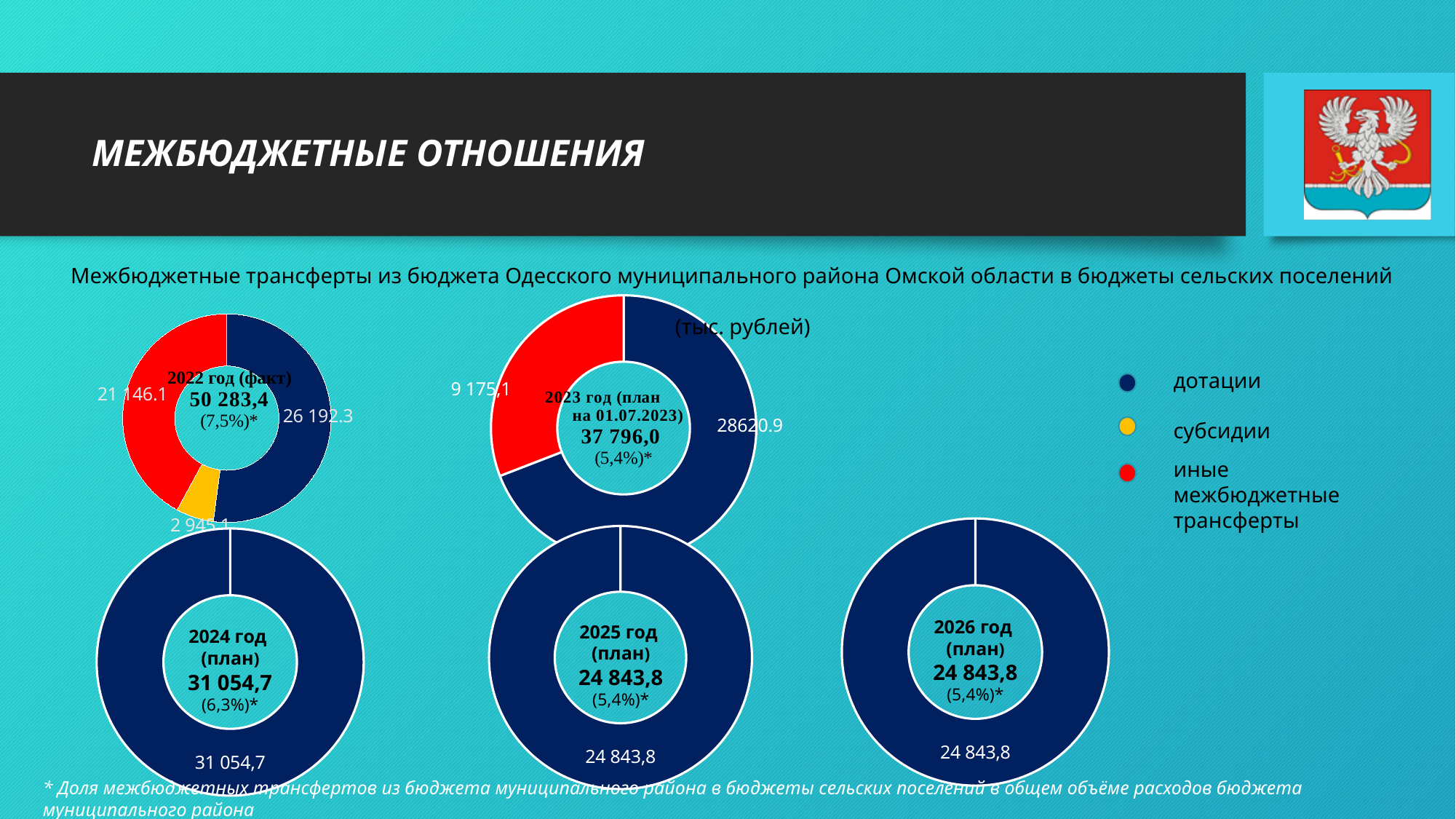
In the 2022 год (факт) chart, what is the value for дотации? 26 192.3 How many slices does the 2022 год (факт) chart have? 3 What is the total shown in the centre of the 2024 год (план) chart? 31 054,7 In the 2023 год (план на 01.07.2023) chart, what is the difference between дотации and иные межбюджетные трансферты? 19445.8 In the 2023 год (план на 01.07.2023) chart, what is the value for иные межбюджетные трансферты? 9 175,1 In the 2022 год (факт) chart, what is the value for иные межбюджетные трансферты? 21 146.1 In the 2022 год (факт) chart, what is the value for субсидии? 2 945.1 In the 2023 год (план на 01.07.2023) chart, which is larger: дотации or иные межбюджетные трансферты? дотации In the 2023 год (план на 01.07.2023) chart, what is the value for дотации? 28620.9 How many entries does the legend on the slide list? 3 In the 2022 год (факт) chart, which category has the largest slice? дотации In the 2022 год (факт) chart, which category has the smallest slice? субсидии